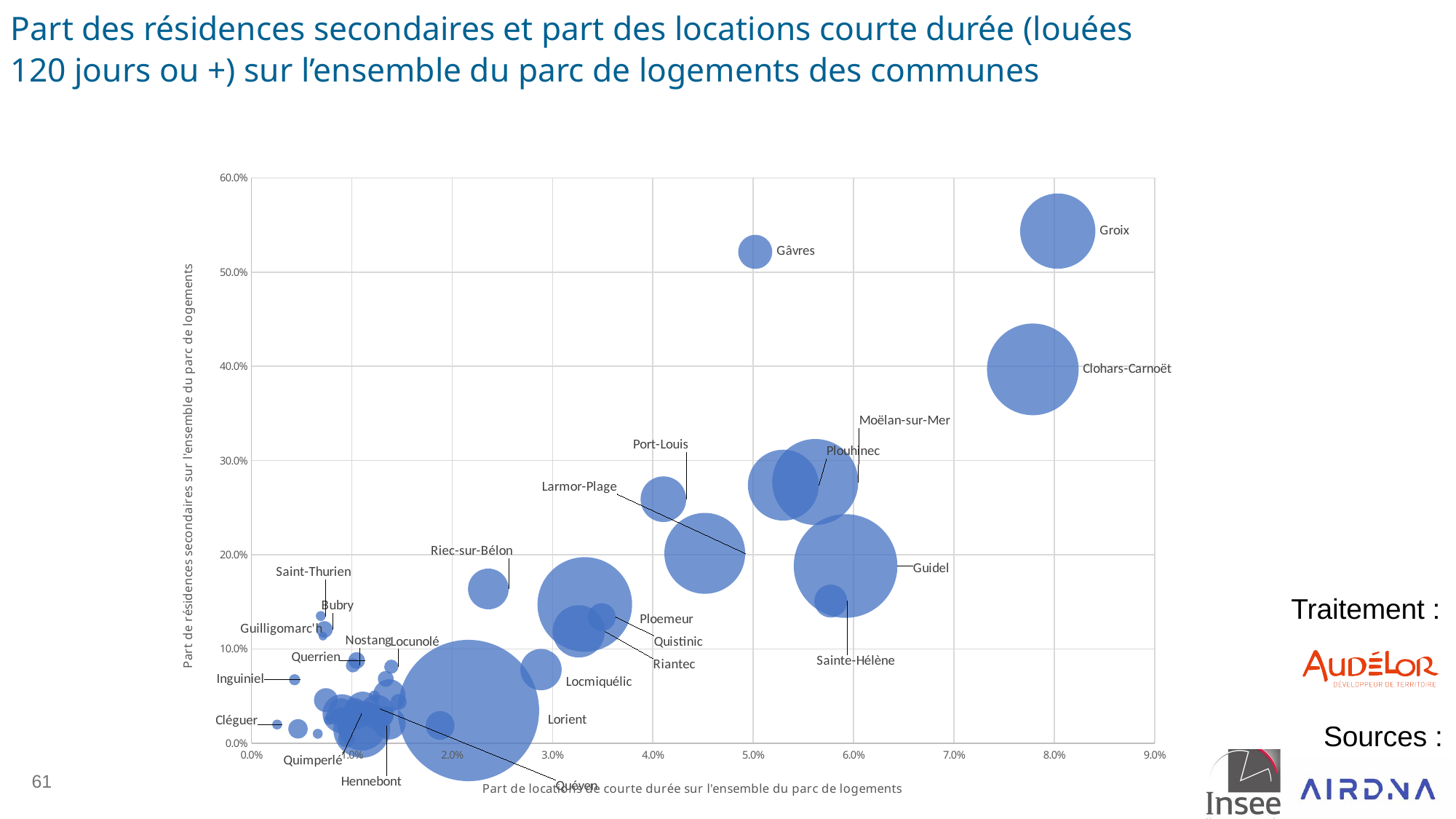
Which commune has the larger share of short-term rentals, Gâvres or Guidel? Guidel Is the share of short-term rentals for Clohars-Carnoët greater or less than 7.0%? greater Is the share of secondary residences for Lorient greater or less than 10.0%? less Is the share of secondary residences for Port-Louis greater or less than 20.0%? greater Which commune has the larger share of secondary residences, Groix or Lorient? Groix What is the title of the horizontal axis? Part de locations de courte durée sur l'ensemble du parc de logements Which commune is represented by the largest bubble? Lorient What kind of chart is shown on the slide? bubble chart Which commune has the highest share of secondary residences (vertical axis)? Groix